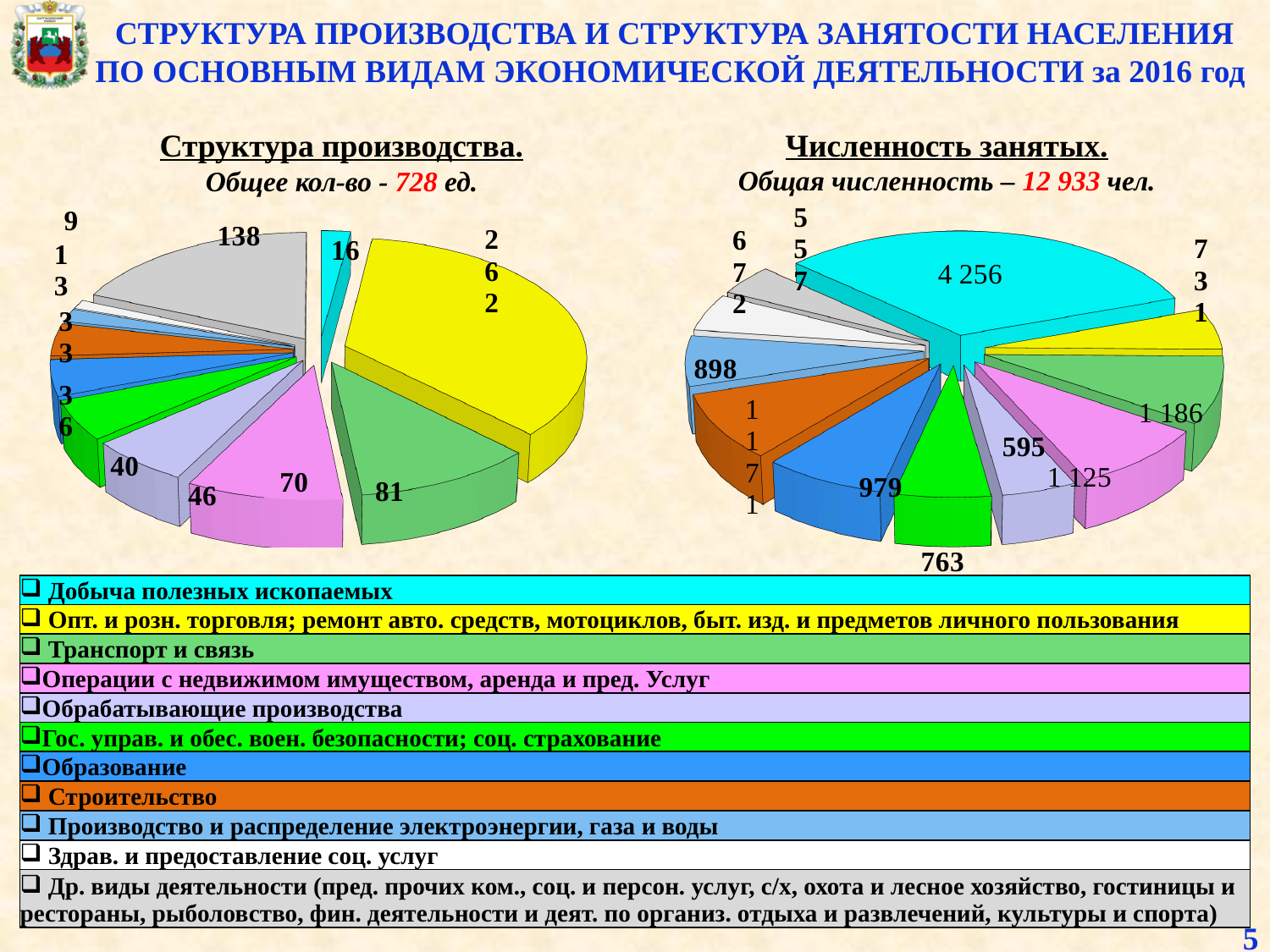
In the right chart (Численность занятых), what is the value for Образование? 979 In the right chart (Численность занятых), what is the value for Транспорт и связь? 1 186 In the left chart (Структура производства), which category has the largest slice? Опт. и розн. торговля; ремонт авто. средств, мотоциклов, быт. изд. и предметов личного пользования How many categories does the legend list? 11 In the left chart (Структура производства), what is the value for Др. виды деятельности? 138 In the left chart (Структура производства), what is the value for Добыча полезных ископаемых? 16 In the right chart (Численность занятых), what is the value for Добыча полезных ископаемых? 4 256 In the left chart (Структура производства), what is the difference between Транспорт и связь and Операции с недвижимом имуществом, аренда и пред. услуг? 11 In the left chart (Структура производства), what is the value for Транспорт и связь? 81 In the right chart (Численность занятых), which is larger: Транспорт и связь or Операции с недвижимом имуществом, аренда и пред. услуг? Транспорт и связь In the right chart (Численность занятых), what is the value for Гос. управ. и обес. воен. безопасности; соц. страхование? 763 What kind of charts are shown on the slide? Pie charts